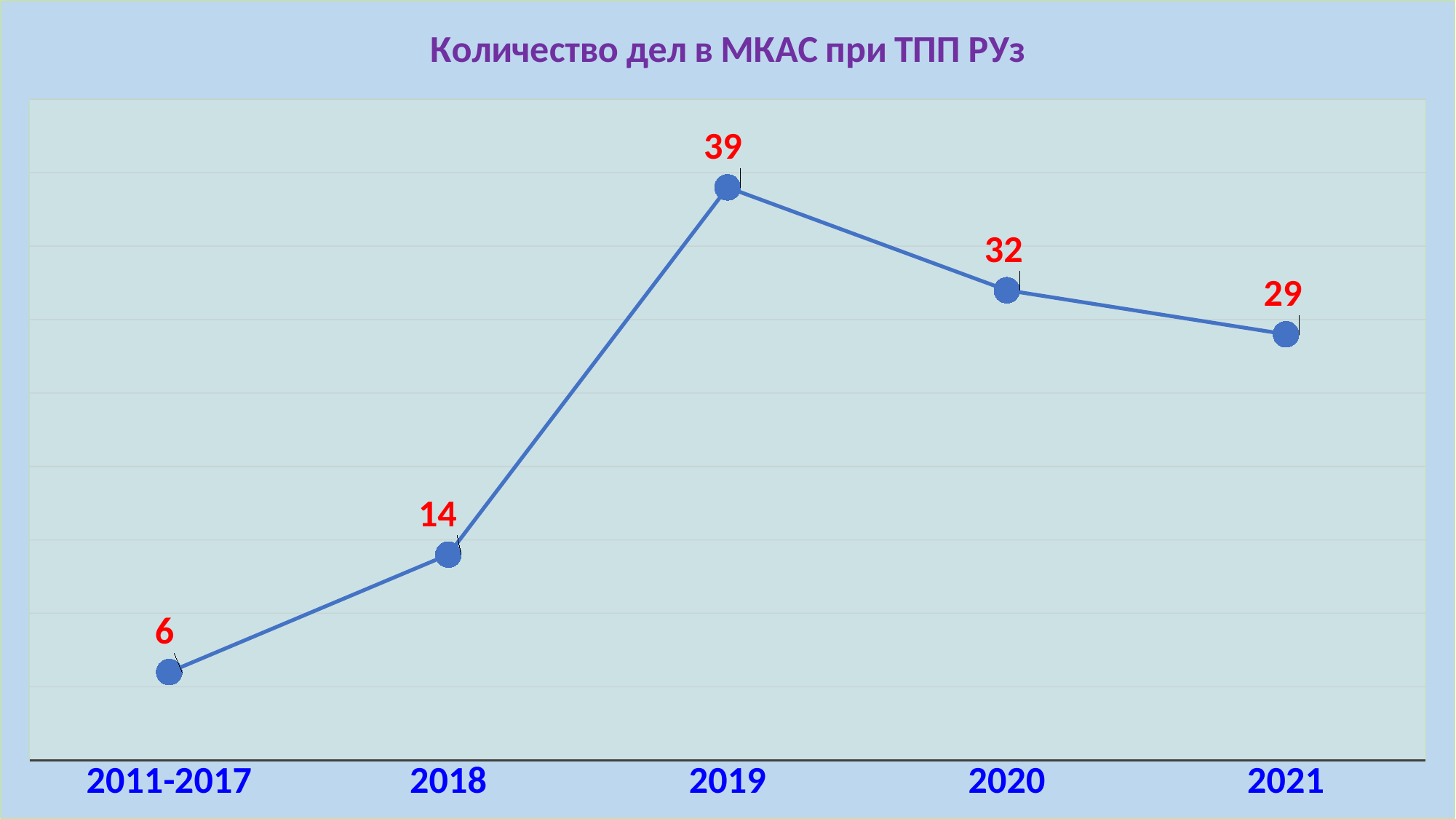
Do the values rise or fall from 2019 to 2021? fall What is the value for 2011-2017? 6 What is the difference between the values for 2018 and 2011-2017? 8 Which category has the lowest value? 2011-2017 What is the value for 2019? 39 What kind of chart is shown on the slide? line chart Which is larger, the value for 2020 or the value for 2021? 2020 What is the title of the chart? Количество дел в МКАС при ТПП РУз How many data points are plotted on the chart? 5 Which category has the highest value? 2019 What is the difference between the values for 2019 and 2020? 7 What is the value for 2021? 29